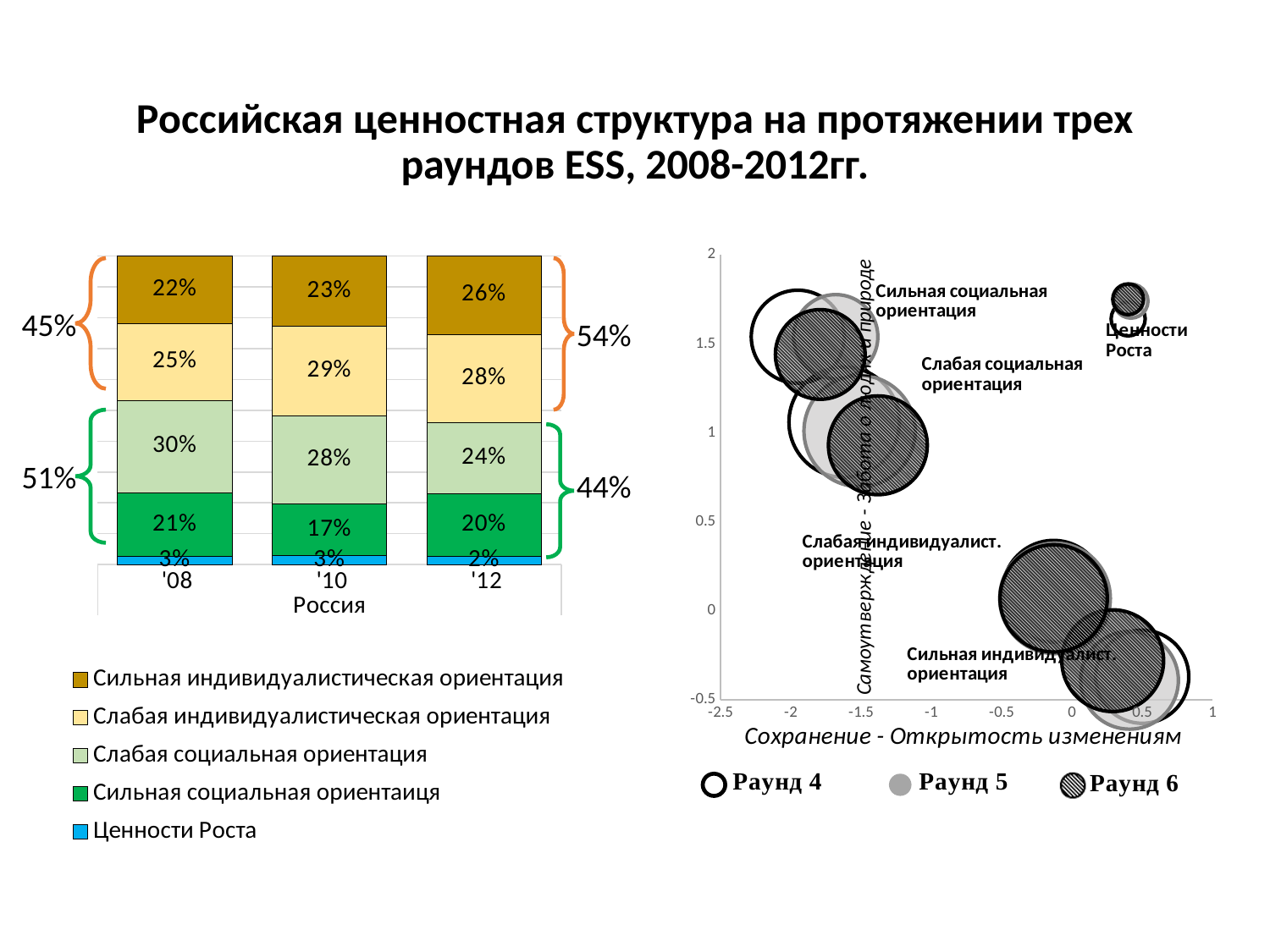
In the left stacked bar chart, what is the value for Ценности Роста in '12? 2% In the right bubble chart, how many rounds does the legend list? 3 In the left stacked bar chart, what is the difference between Слабая социальная ориентация in '08 and in '12? 6% In the left stacked bar chart, which year has the highest value for Слабая индивидуалистическая ориентация? '10 In the left stacked bar chart, what is the value for Сильная индивидуалистическая ориентация in '12? 26% In the left stacked bar chart, what is the value for Сильная социальная ориентаиця in '10? 17% In the left stacked bar chart, does the value for Сильная индивидуалистическая ориентация rise or fall from '08 to '12? rise In the left stacked bar chart, how many years (bars) are shown? 3 In the left stacked bar chart, how many series does the legend list? 5 In the left stacked bar chart, is Сильная индивидуалистическая ориентация larger in '08 or in '12? '12 In the left stacked bar chart, what is the value for Слабая социальная ориентация in '08? 30% In the left stacked bar chart, which year has the lowest value for Сильная социальная ориентаиця? '10